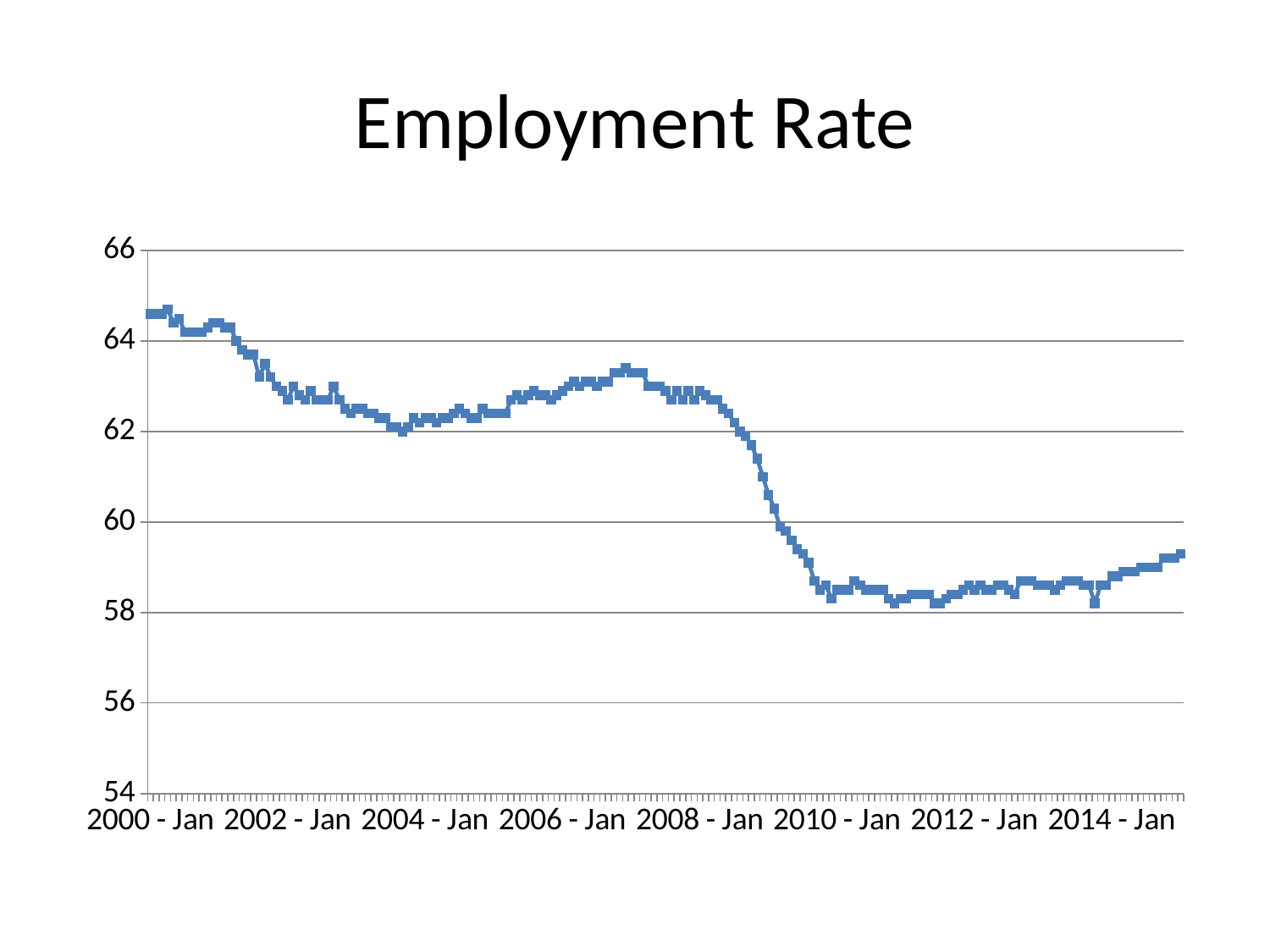
Does the employment rate rise or fall between 2012 - Jan and 2014 - Jan? rise Does the employment rate rise or fall between 2008 - Jan and 2010 - Jan? fall What is the highest value labelled on the vertical axis? 66 Is the employment rate at 2008 - Jan greater or less than 62? greater Is the employment rate at 2000 - Jan greater or less than 64? greater Which is higher, the employment rate at 2000 - Jan or at 2014 - Jan? 2000 - Jan Is the employment rate at 2004 - Jan greater or less than 64? less What is the title of the chart? Employment Rate What kind of chart is shown on the slide? line chart